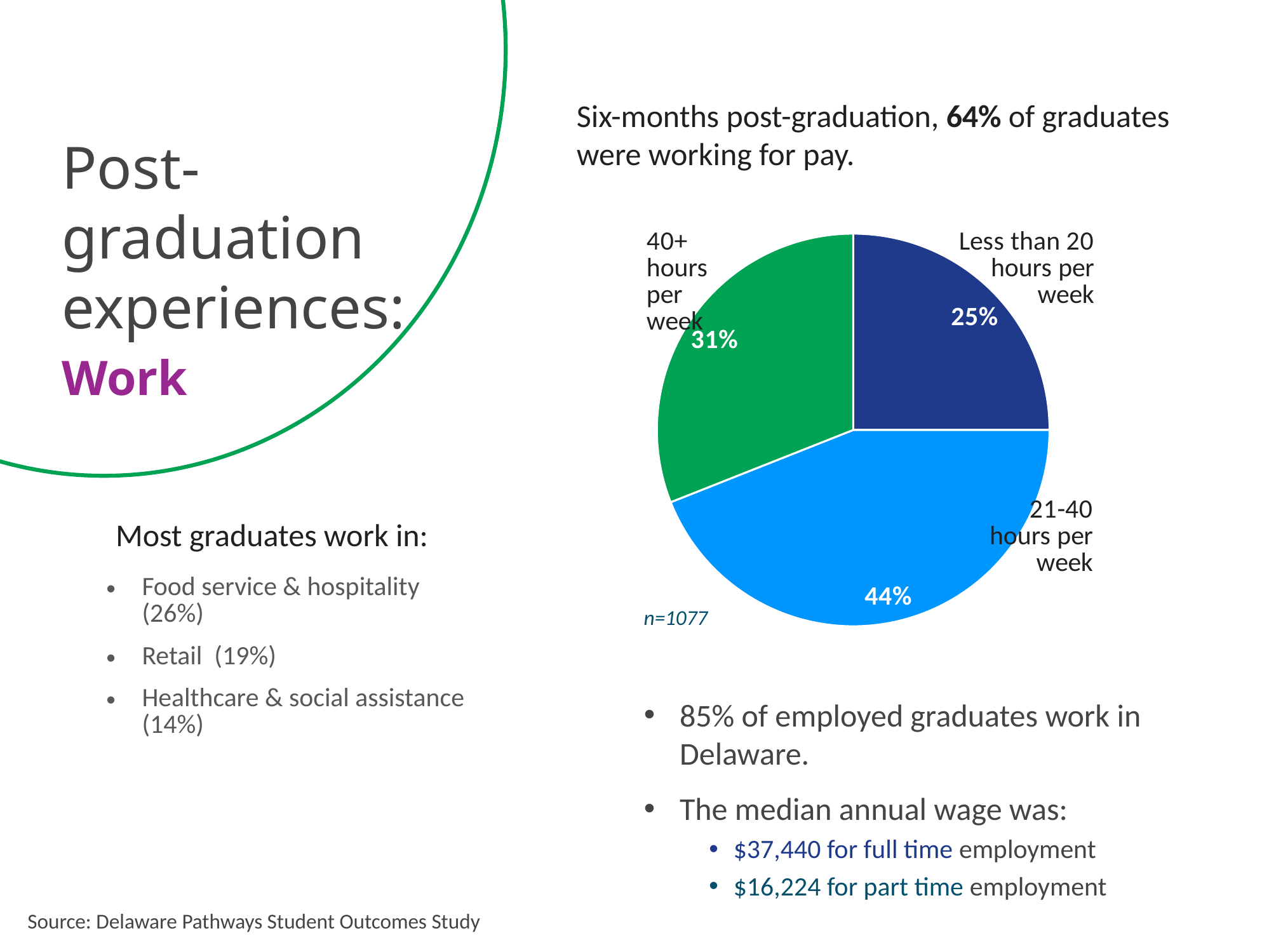
Which category has the largest slice of the pie? 21-40 hours per week What share of the pie is labelled for 21-40 hours per week? 44% What is the difference in percentage points between the 21-40 hours per week slice and the 40+ hours per week slice? 13 What sample size (n) is noted beneath the pie chart? n=1077 Which slice is larger: 40+ hours per week or Less than 20 hours per week? 40+ hours per week What kind of chart is shown on the slide? pie chart What share of the pie is labelled for 40+ hours per week? 31% What colour is the slice for 40+ hours per week? green Which category has the smallest slice of the pie? Less than 20 hours per week What share of the pie is labelled for Less than 20 hours per week? 25% How many slices does the pie chart have? 3 What is the difference in percentage points between the 40+ hours per week slice and the Less than 20 hours per week slice? 6